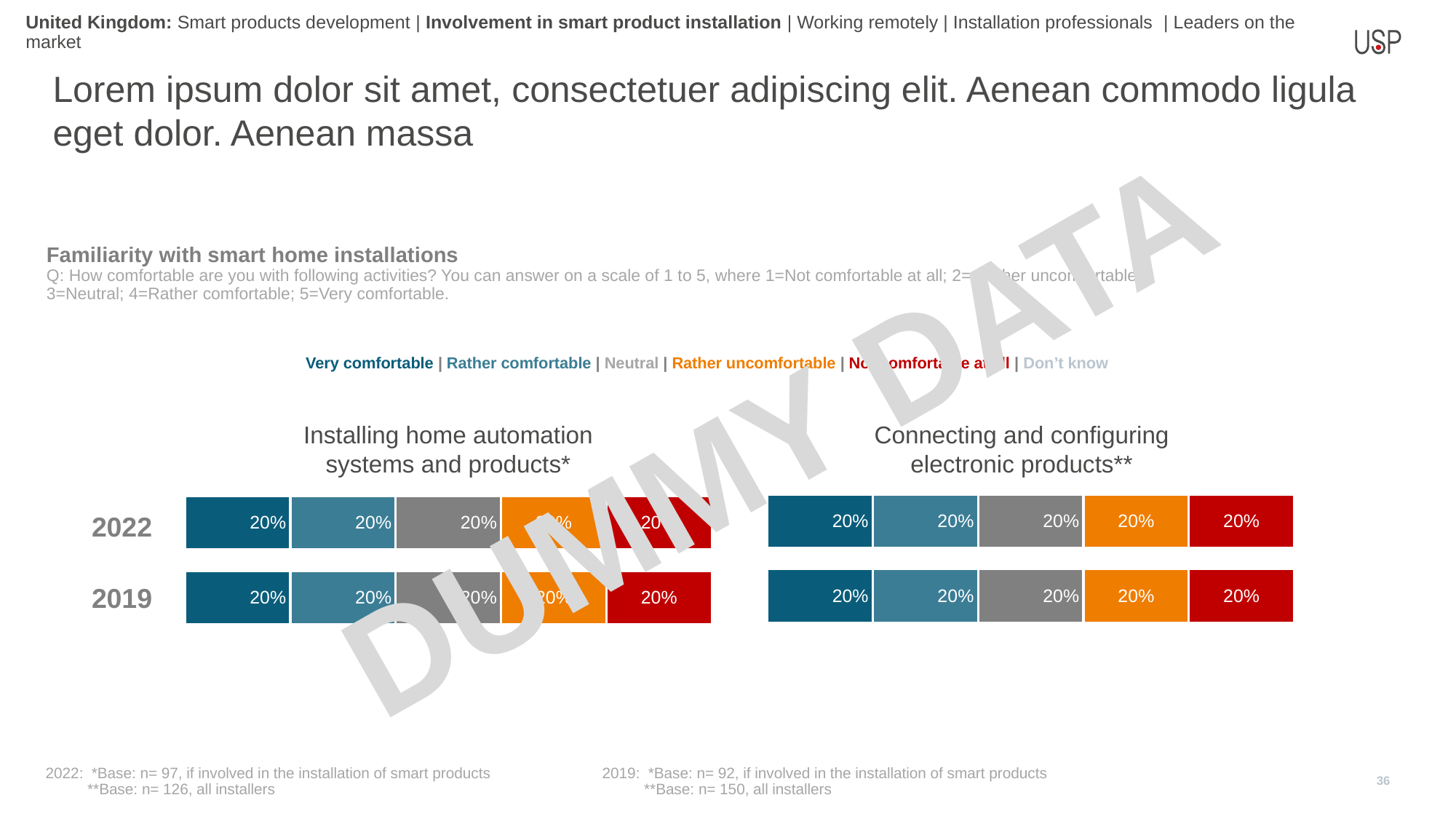
In the 'Connecting and configuring electronic products**' chart, what is the 'Very comfortable' value for 2022? 20% Which legend entry is shown in red? Not comfortable at all In the 'Connecting and configuring electronic products**' chart, what is the difference between the 'Very comfortable' value for 2022 and for 2019? 0% In the 'Installing home automation systems and products*' chart, what is the 'Rather comfortable' value for 2022? 20% In the 'Installing home automation systems and products*' chart, what is the 'Not comfortable at all' value for 2019? 20% How many years (rows) are shown in the 'Installing home automation systems and products*' chart? 2 What is the title of the chart section above the two bar charts? Familiarity with smart home installations What kind of chart is used for 'Connecting and configuring electronic products**'? Stacked bar chart In the 'Connecting and configuring electronic products**' chart, what is the 'Not comfortable at all' value for 2019? 20% In the 'Connecting and configuring electronic products**' chart, what is the total of the five labelled segments for 2022? 100% How many response categories does the legend list? 6 In the 'Connecting and configuring electronic products**' chart, what is the 'Neutral' value for 2019? 20%